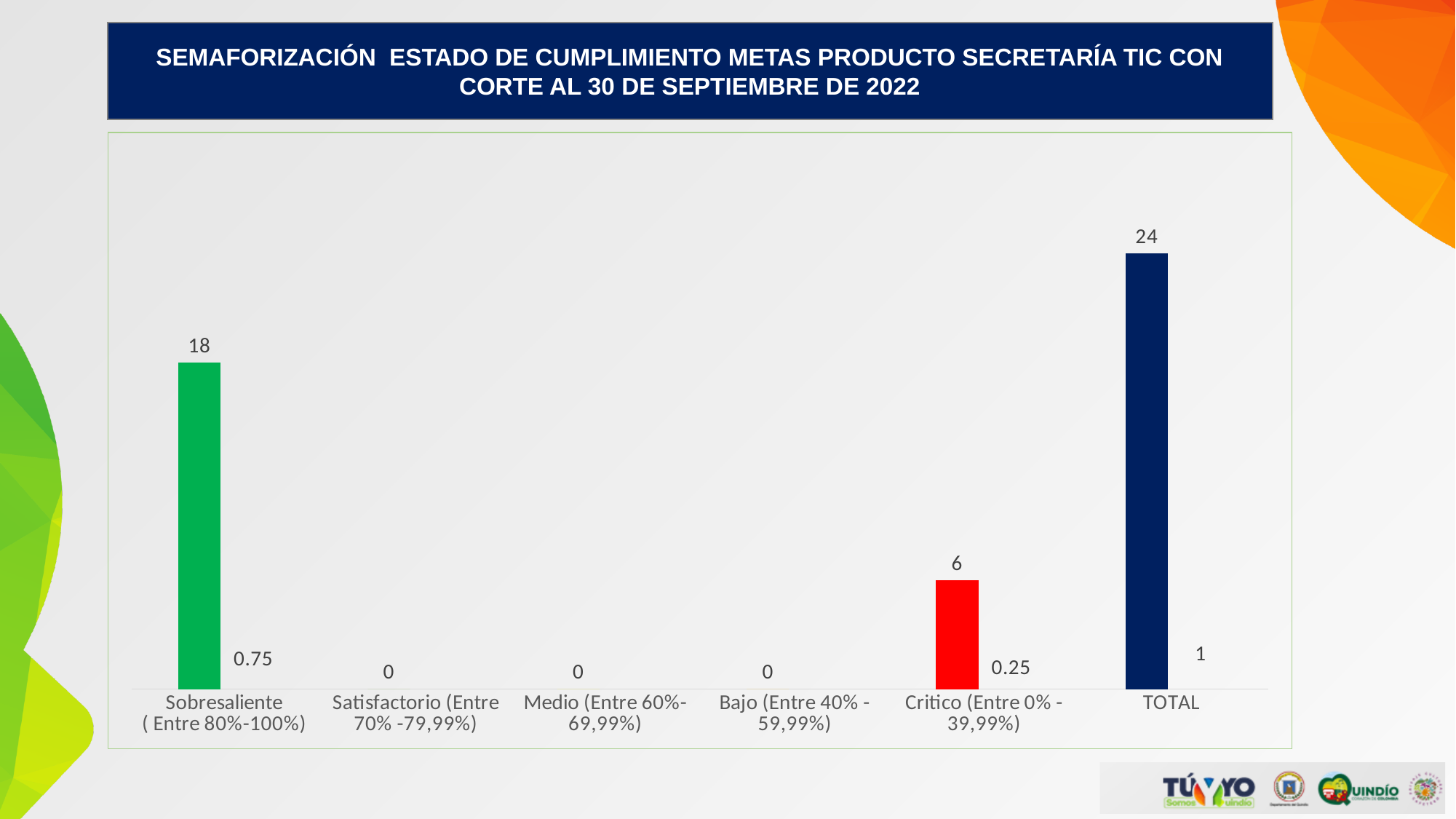
Which has a larger count, Sobresaliente ( Entre 80%-100%) or Critico (Entre 0% - 39,99%)? Sobresaliente ( Entre 80%-100%) What is the difference between the count for Sobresaliente ( Entre 80%-100%) and the count for Critico (Entre 0% - 39,99%)? 12 How many categories are shown on the x axis of the chart? 6 What type of chart is shown on the slide? Bar chart Excluding TOTAL, which category has the highest count? Sobresaliente ( Entre 80%-100%) What is the count value shown for the Medio (Entre 60%-69,99%) category? 0 What proportion value is printed next to the Sobresaliente ( Entre 80%-100%) bar? 0.75 What colour is the bar for the Critico (Entre 0% - 39,99%) category? Red What is the count value shown for the Critico (Entre 0% - 39,99%) category? 6 What is the count value shown for the Sobresaliente ( Entre 80%-100%) category? 18 What is the count value shown for the TOTAL category? 24 What proportion value is printed next to the Critico (Entre 0% - 39,99%) bar? 0.25